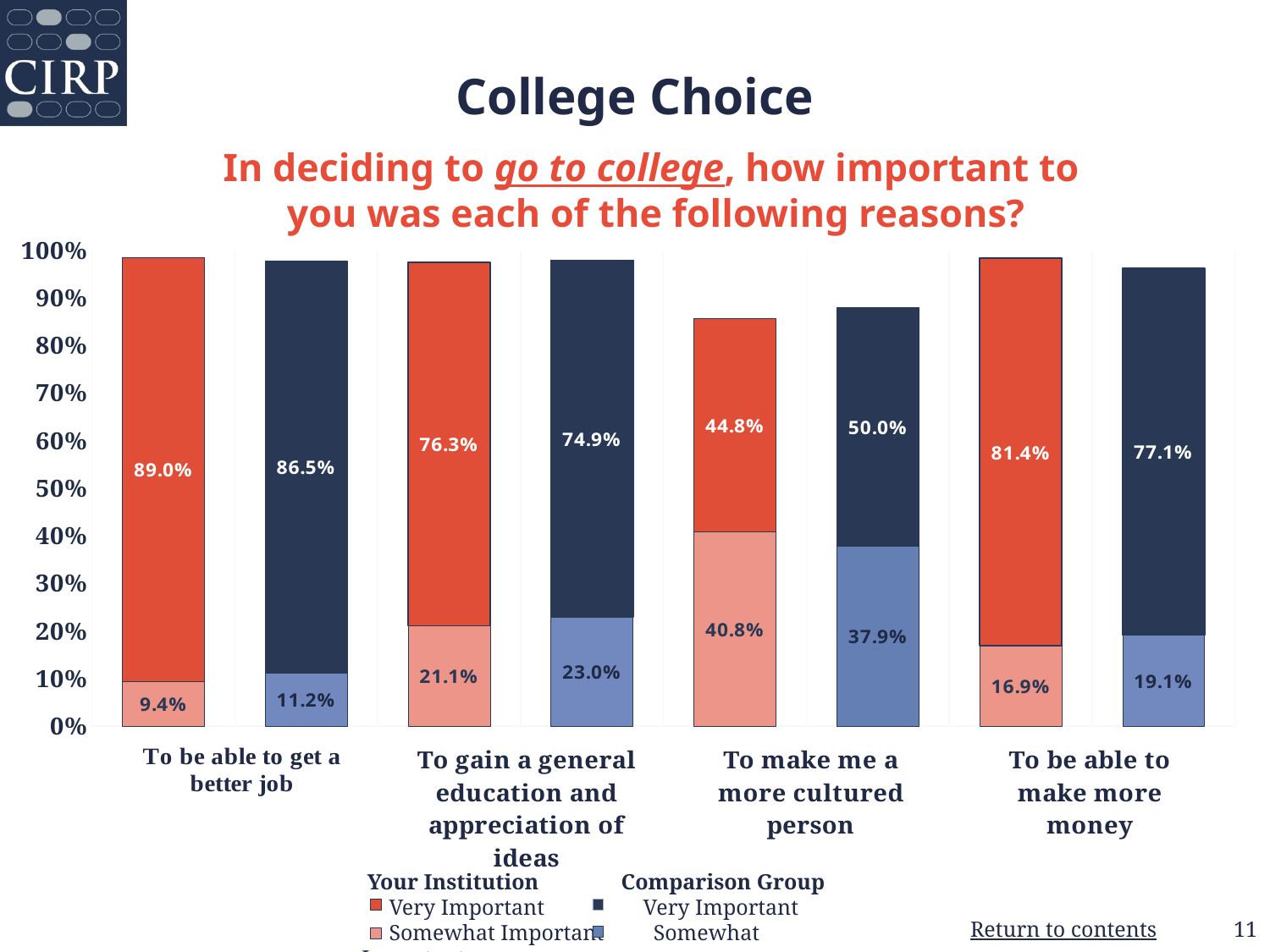
How many reasons (categories) are shown on the x axis? 4 What is the combined total of Very Important and Somewhat Important for Your Institution for "To be able to make more money"? 98.3% What percentage of the Comparison Group rated "To make me a more cultured person" as Somewhat Important? 37.9% Which reason has the highest Very Important percentage for Your Institution? To be able to get a better job How many series does the legend list? 4 What colour represents Very Important for Your Institution? Red For "To make me a more cultured person", which group has the larger Very Important percentage, Your Institution or the Comparison Group? Comparison Group What is the difference between the Your Institution and Comparison Group Very Important values for "To gain a general education and appreciation of ideas"? 1.4% What percentage of Your Institution students rated "To be able to get a better job" as Very Important? 89.0% Which reason has the lowest Very Important percentage for the Comparison Group? To make me a more cultured person What kind of chart is shown on the slide? Stacked bar chart What is the Very Important value for the Comparison Group for "To be able to make more money"? 77.1%